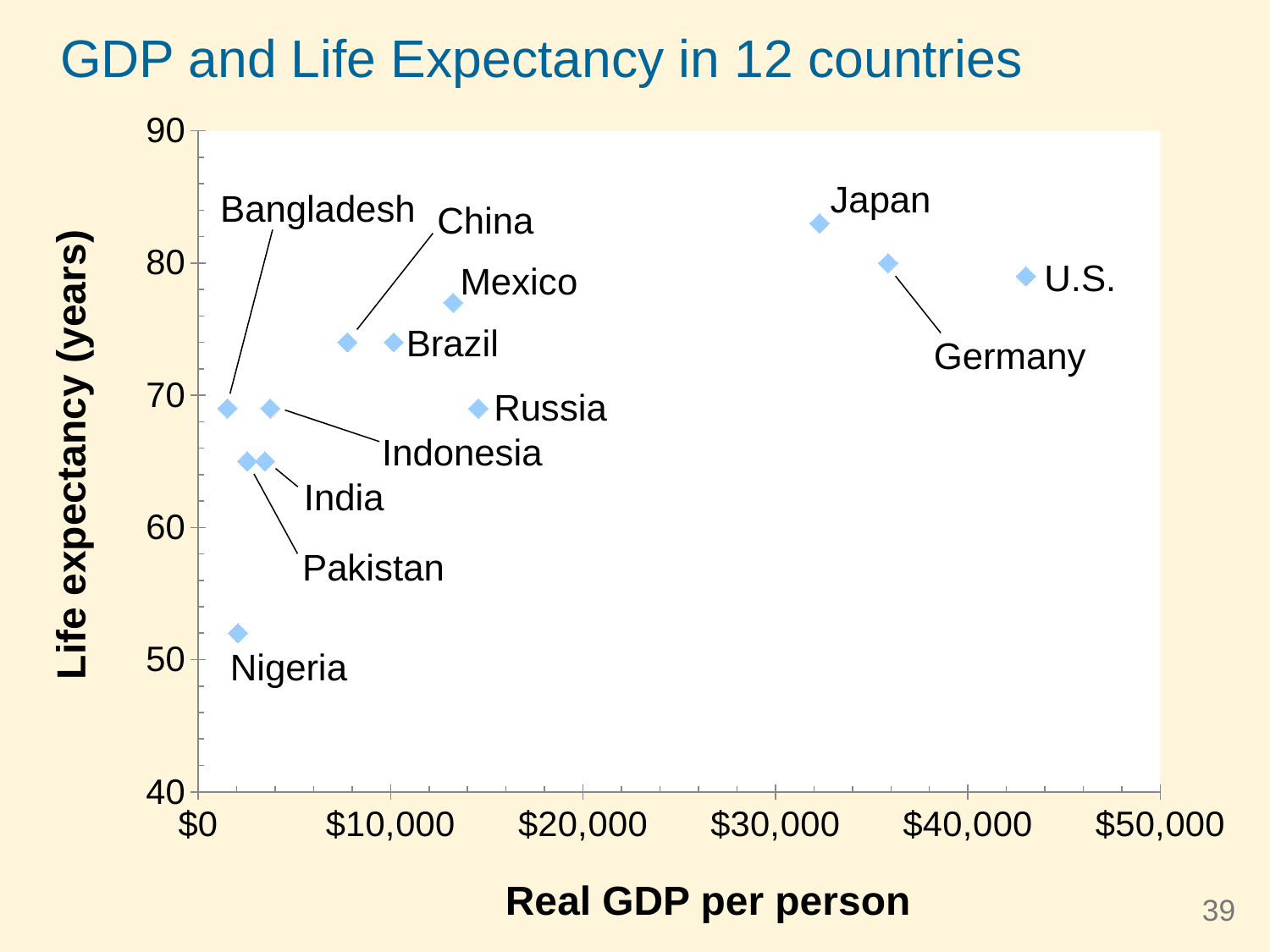
How many countries are plotted on the chart? 12 Which has the higher life expectancy, Japan or the U.S.? Japan What is the label of the horizontal axis? Real GDP per person Which country has the highest real GDP per person on the chart? U.S. What kind of chart is shown on the slide? scatter plot Which country has the highest life expectancy on the chart? Japan Which has the higher life expectancy, Mexico or Russia? Mexico Is the life expectancy for Nigeria greater or less than 60 years? less Is the life expectancy for Japan greater or less than 80 years? greater Is the real GDP per person for Russia greater or less than $20,000? less Which country has the lowest life expectancy on the chart? Nigeria